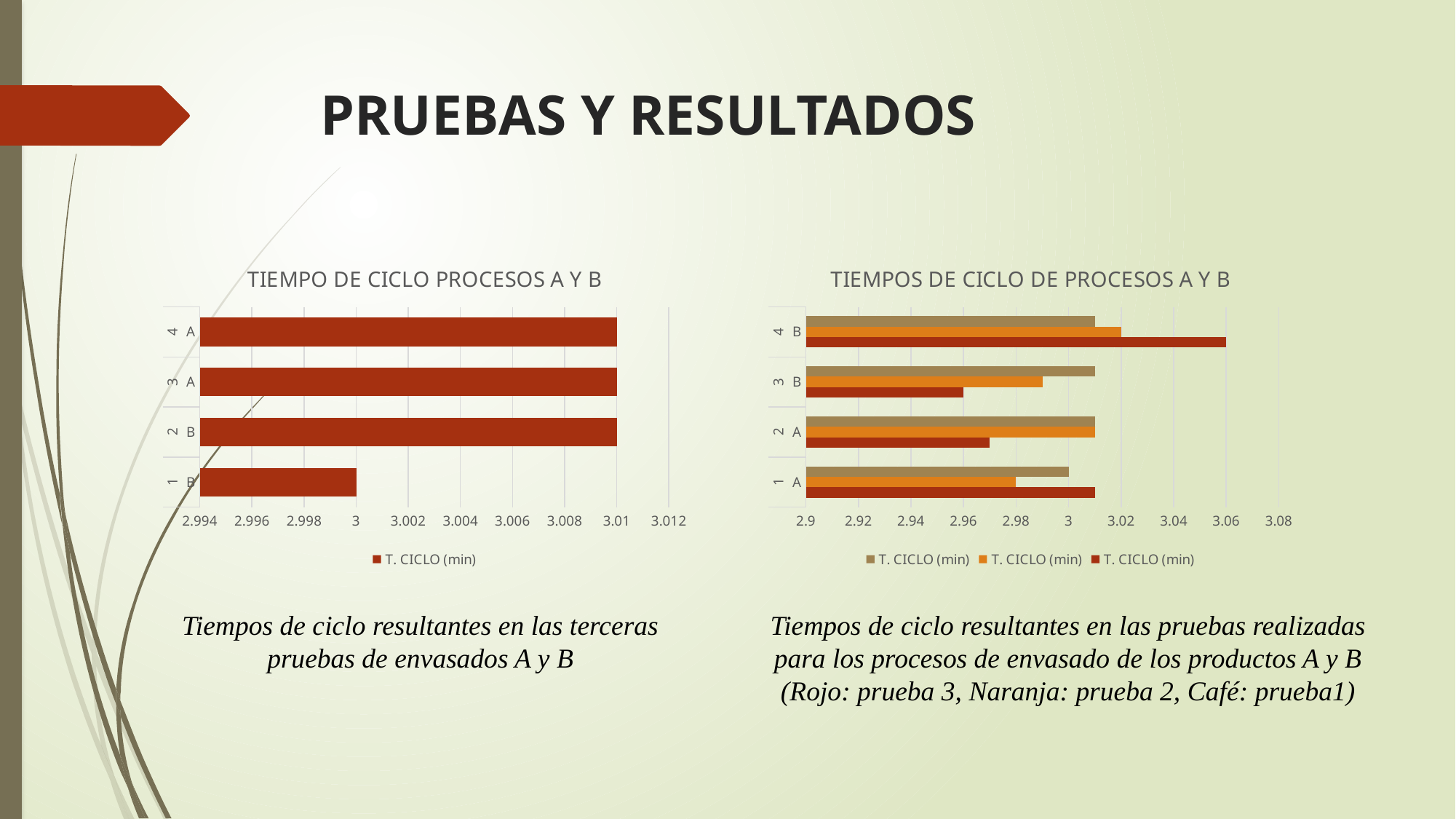
What kind of chart is the left chart titled 'TIEMPO DE CICLO PROCESOS A Y B'? bar chart In the left chart 'TIEMPO DE CICLO PROCESOS A Y B', what is the value for category 4 A? 3.01 In the left chart 'TIEMPO DE CICLO PROCESOS A Y B', what is the difference between the values for 4 A and 1 B? 0.01 In the right chart 'TIEMPOS DE CICLO DE PROCESOS A Y B', which category has the longest red bar? 4 B In the right chart 'TIEMPOS DE CICLO DE PROCESOS A Y B', is the red bar for category 2 A greater or less than 3? less In the right chart 'TIEMPOS DE CICLO DE PROCESOS A Y B', for category 3 B, which is larger: the orange bar or the red bar? orange bar How many series does the legend of the right chart 'TIEMPOS DE CICLO DE PROCESOS A Y B' list? 3 In the right chart 'TIEMPOS DE CICLO DE PROCESOS A Y B', what is the value of the red bar for category 4 B? 3.06 In the left chart 'TIEMPO DE CICLO PROCESOS A Y B', what is the value for category 1 B? 3 How many categories are shown in the left chart 'TIEMPO DE CICLO PROCESOS A Y B'? 4 In the left chart 'TIEMPO DE CICLO PROCESOS A Y B', which category has the lowest value? 1 B In the right chart 'TIEMPOS DE CICLO DE PROCESOS A Y B', what is the value of the red bar for category 3 B? 2.96